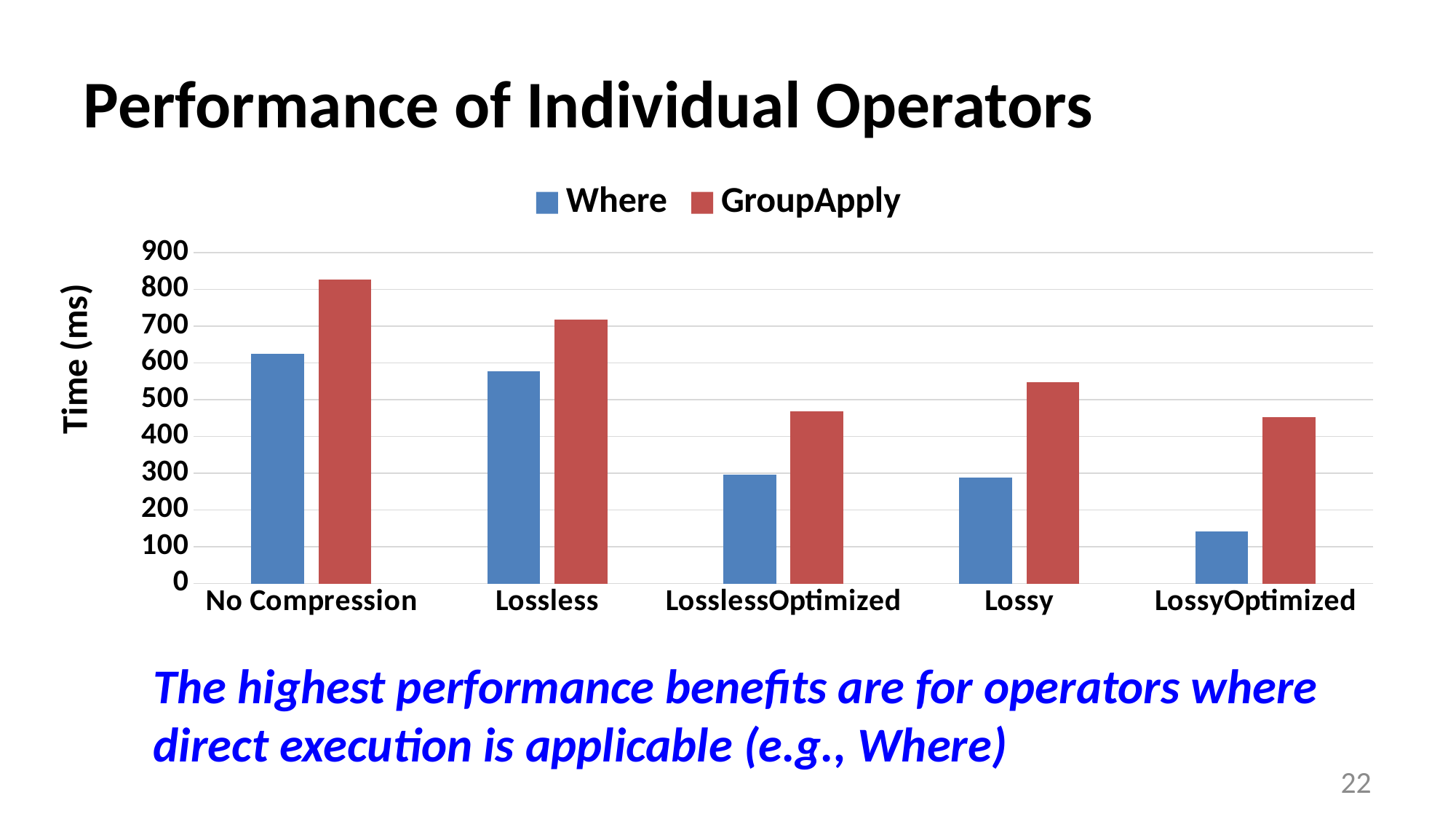
How many compression categories are shown on the x axis? 5 Is the GroupApply value for No Compression greater or less than 700? greater Is the Where value for Lossless greater or less than 500? greater How many series does the legend list? 2 What kind of chart is shown on the slide? bar chart Do the Where values rise or fall going from No Compression to LossyOptimized along the x axis? fall For which category is the Where bar lowest? LossyOptimized Is the Where value for LossyOptimized greater or less than 200? less Which is larger: the GroupApply value for Lossless or the GroupApply value for Lossy? Lossless For which category is the GroupApply bar highest? No Compression What is the label of the y axis? Time (ms)